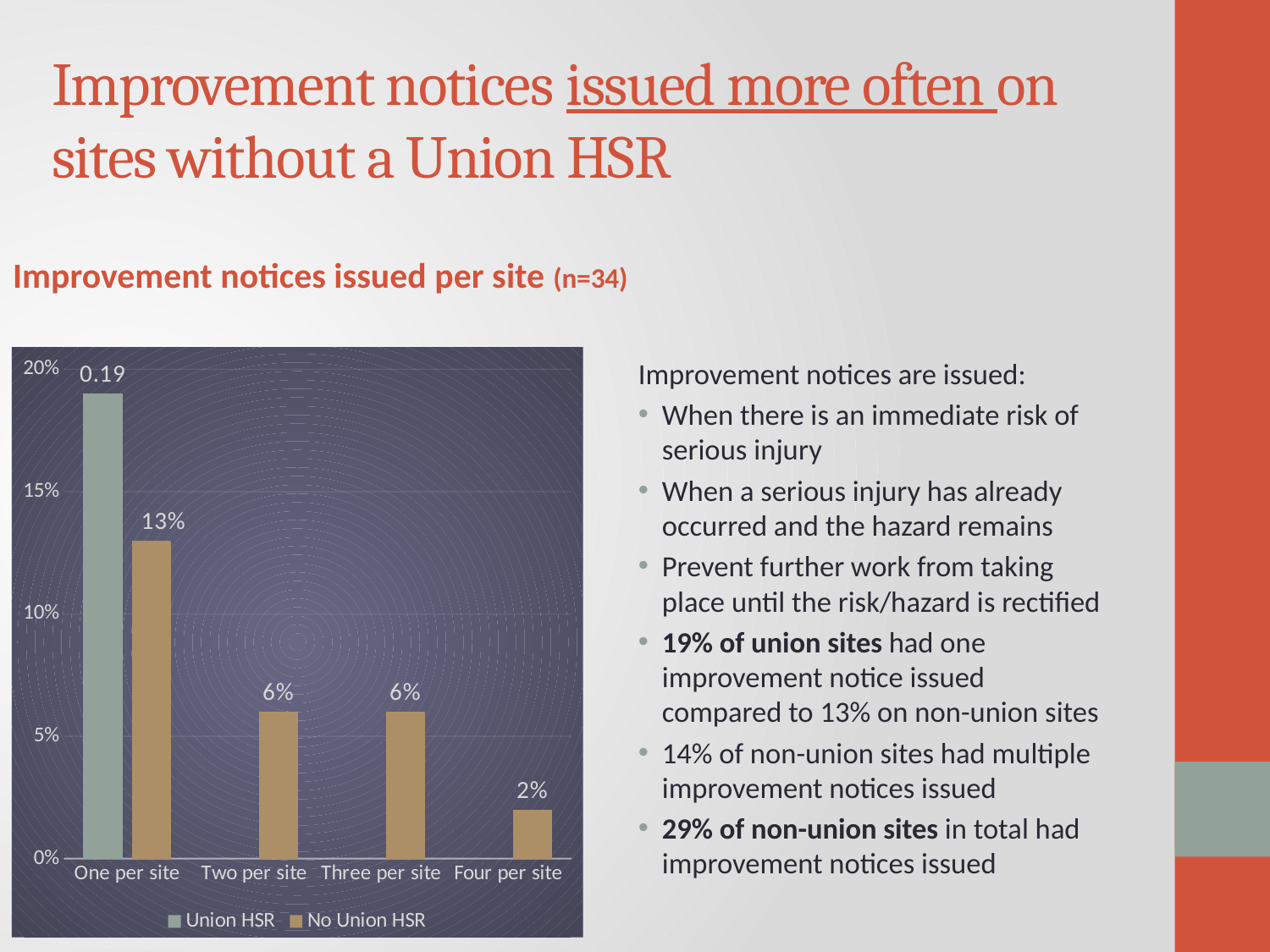
What is the value for No Union HSR at Four per site? 2% What is the value for No Union HSR at One per site? 13% What kind of chart is shown on the slide? Bar chart What is the difference between the No Union HSR values for One per site and Four per site? 11 percentage points What is the value for No Union HSR at Two per site? 6% Which category has the lowest value for No Union HSR? Four per site What data label is shown on the Union HSR bar for One per site? 0.19 For One per site, which series has the larger value, Union HSR or No Union HSR? Union HSR How many categories are shown on the x axis? 4 Is the No Union HSR value for One per site greater or less than 10%? greater Which category has the highest value for No Union HSR? One per site How many series does the legend list? 2